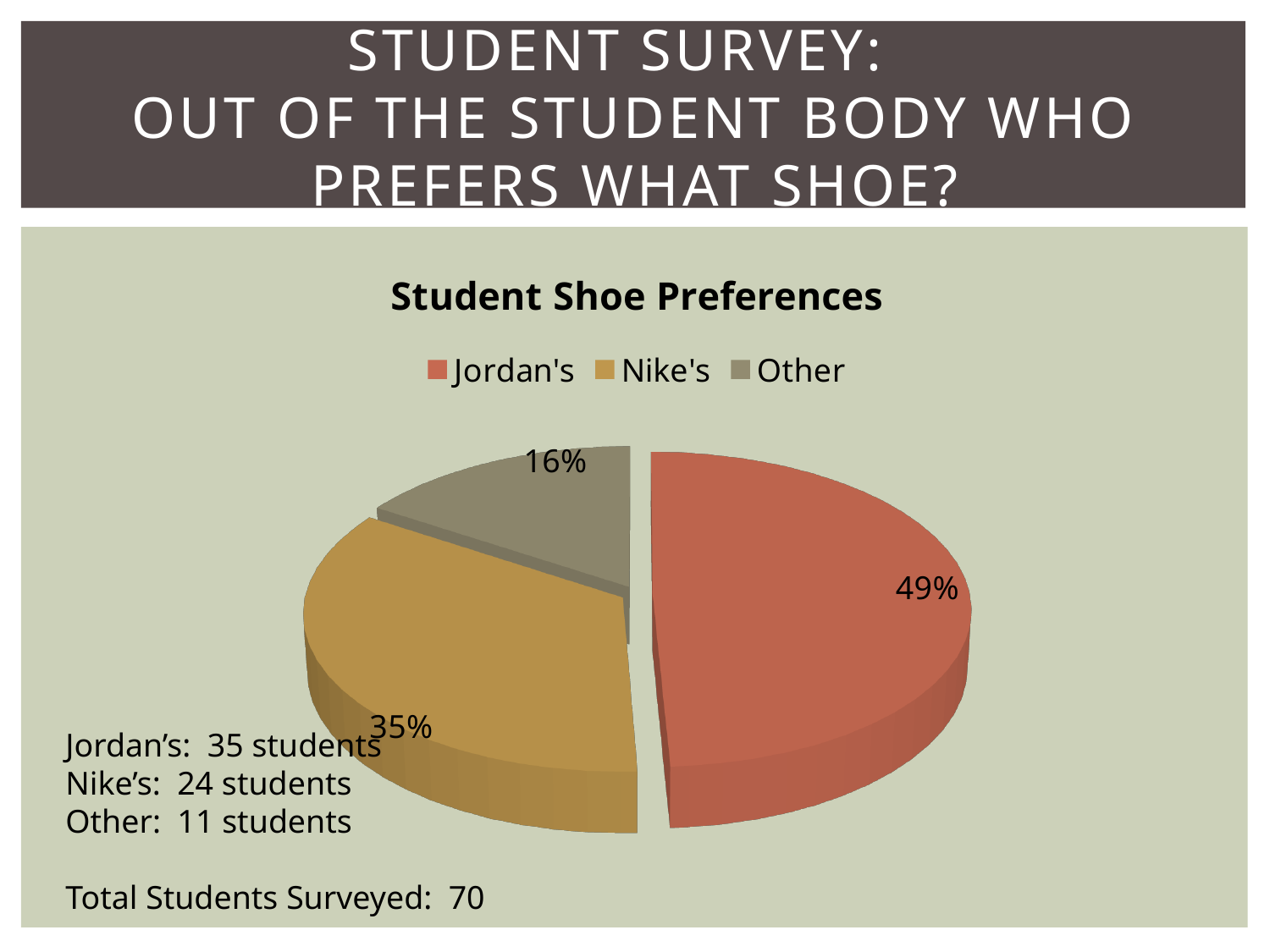
What is the title of the chart? Student Shoe Preferences Which category has the largest share of the pie? Jordan's Which colour represents Nike's in the pie chart? gold What is the difference in percentage points between Jordan's and Nike's shares? 14 Which has a larger share, Nike's or Other? Nike's What percentage of the pie is Jordan's? 49% What percentage of the pie is Other? 16% How many slices does the pie chart have? 3 What percentage of the pie is Nike's? 35% Which category has the smallest share of the pie? Other What type of chart is shown on the slide? pie chart How many entries does the legend list? 3